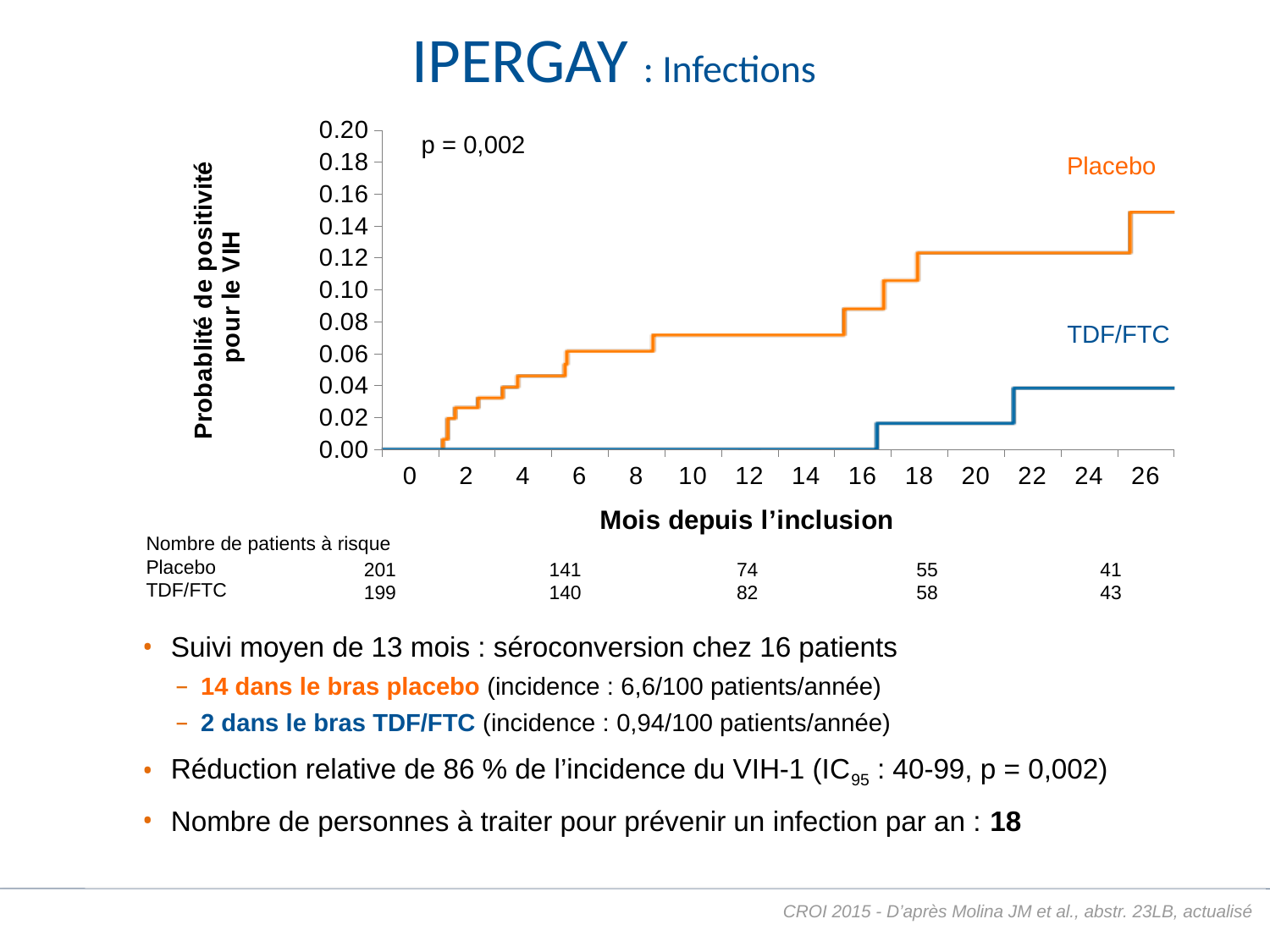
How many series are plotted on the chart? 2 Does the Placebo curve rise or fall as months since inclusion increase? rise Is the TDF/FTC value at month 26 greater or less than 0.06? less What kind of chart is shown on the slide? line chart In the number of patients at risk table, how many Placebo patients are at risk at the first time point? 201 In the number of patients at risk table, how many TDF/FTC patients are at risk at the last time point? 43 Is the Placebo value at month 26 greater or less than 0.10? greater Is the Placebo value at month 12 greater or less than 0.06? greater At month 20, which series has the higher probability of HIV positivity, Placebo or TDF/FTC? Placebo Which two series are labelled on the chart? Placebo and TDF/FTC What is the label of the x axis? Mois depuis l'inclusion